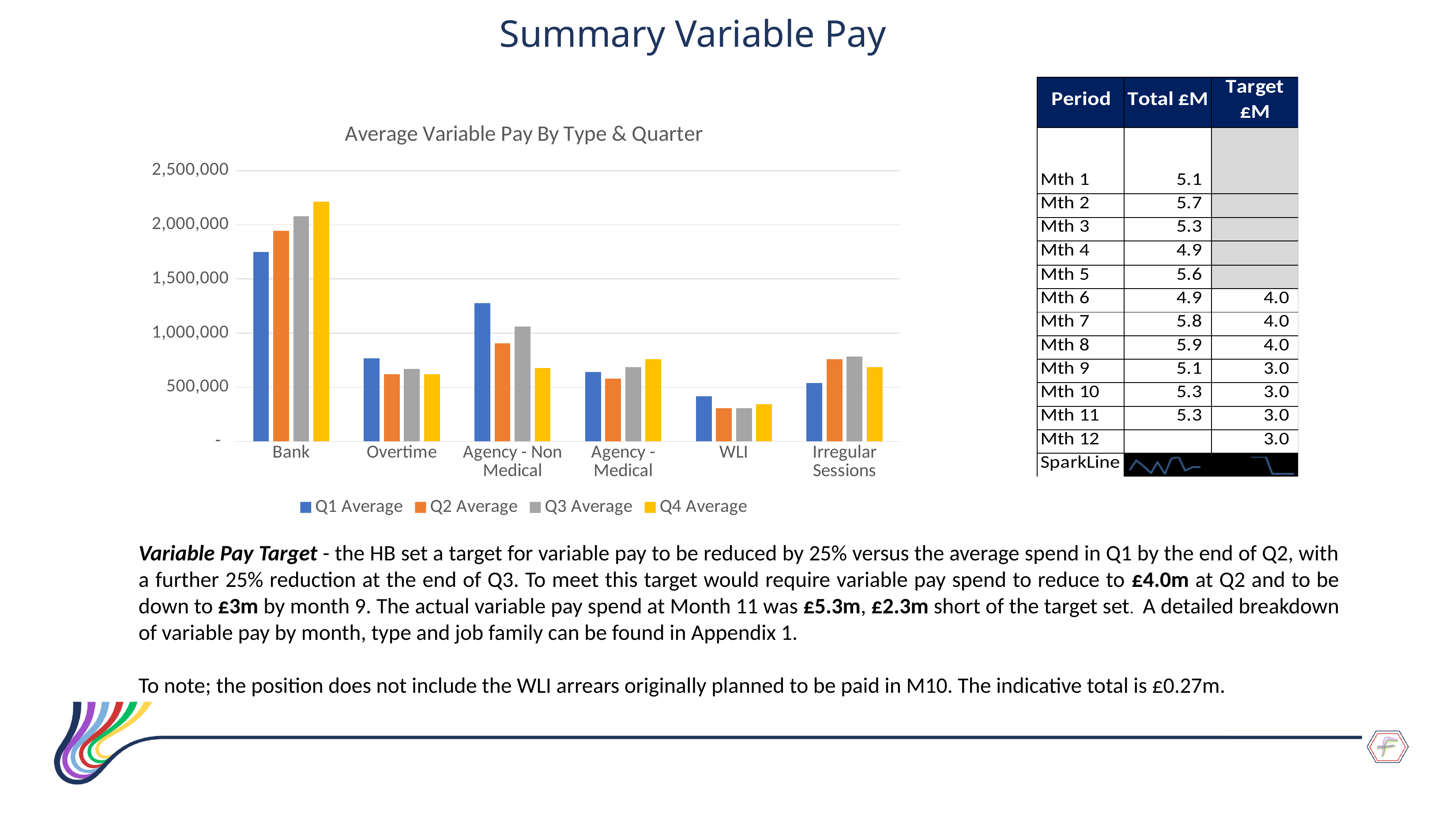
How many variable pay types (categories) are shown on the x axis of the chart? 6 Which category has the highest Q4 Average value? Bank Is the Q2 Average value for WLI greater or less than 500,000? less What is the title of the chart? Average Variable Pay By Type & Quarter For the Bank category, do the values rise or fall from Q1 Average to Q4 Average? rise Which is larger, the Q1 Average for Bank or the Q1 Average for Agency - Non Medical? Bank Which category has the lowest Q2 Average value? WLI Which is larger for Overtime, the Q1 Average or the Q2 Average? Q1 Average What kind of chart is shown on the slide? Bar chart Is the Q1 Average value for Agency - Non Medical greater or less than 1,000,000? greater How many series does the chart legend list? 4 Is the Q4 Average value for Bank greater or less than 2,000,000? greater